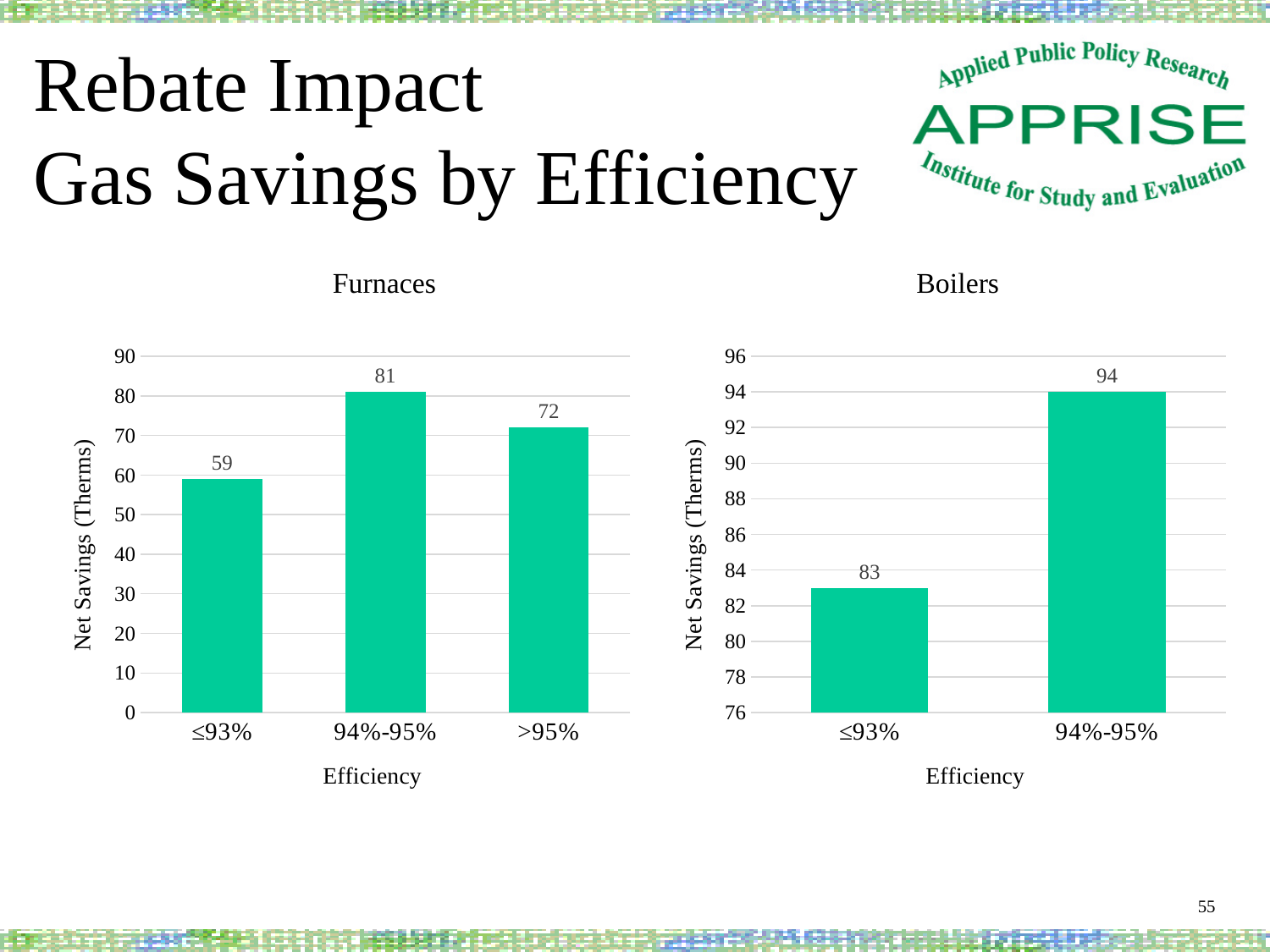
What type of chart is the Boilers chart? Bar chart In the Boilers chart, what is the difference in net savings between the 94%-95% and ≤93% categories? 11 In the Boilers chart, what is the net savings for the 94%-95% efficiency category? 94 How many efficiency categories are shown in the Furnaces chart? 3 In the Furnaces chart, which efficiency category has the lowest net savings? ≤93% In the Furnaces chart, which has higher net savings: ≤93% or >95%? >95% What is the y-axis label of the Furnaces chart? Net Savings (Therms) In the Furnaces chart, what is the difference in net savings between the 94%-95% and >95% categories? 9 How many efficiency categories are shown in the Boilers chart? 2 In the Furnaces chart, what is the net savings for the 94%-95% efficiency category? 81 In the Furnaces chart, which efficiency category has the highest net savings? 94%-95% In the Furnaces chart, what is the net savings for the ≤93% efficiency category? 59